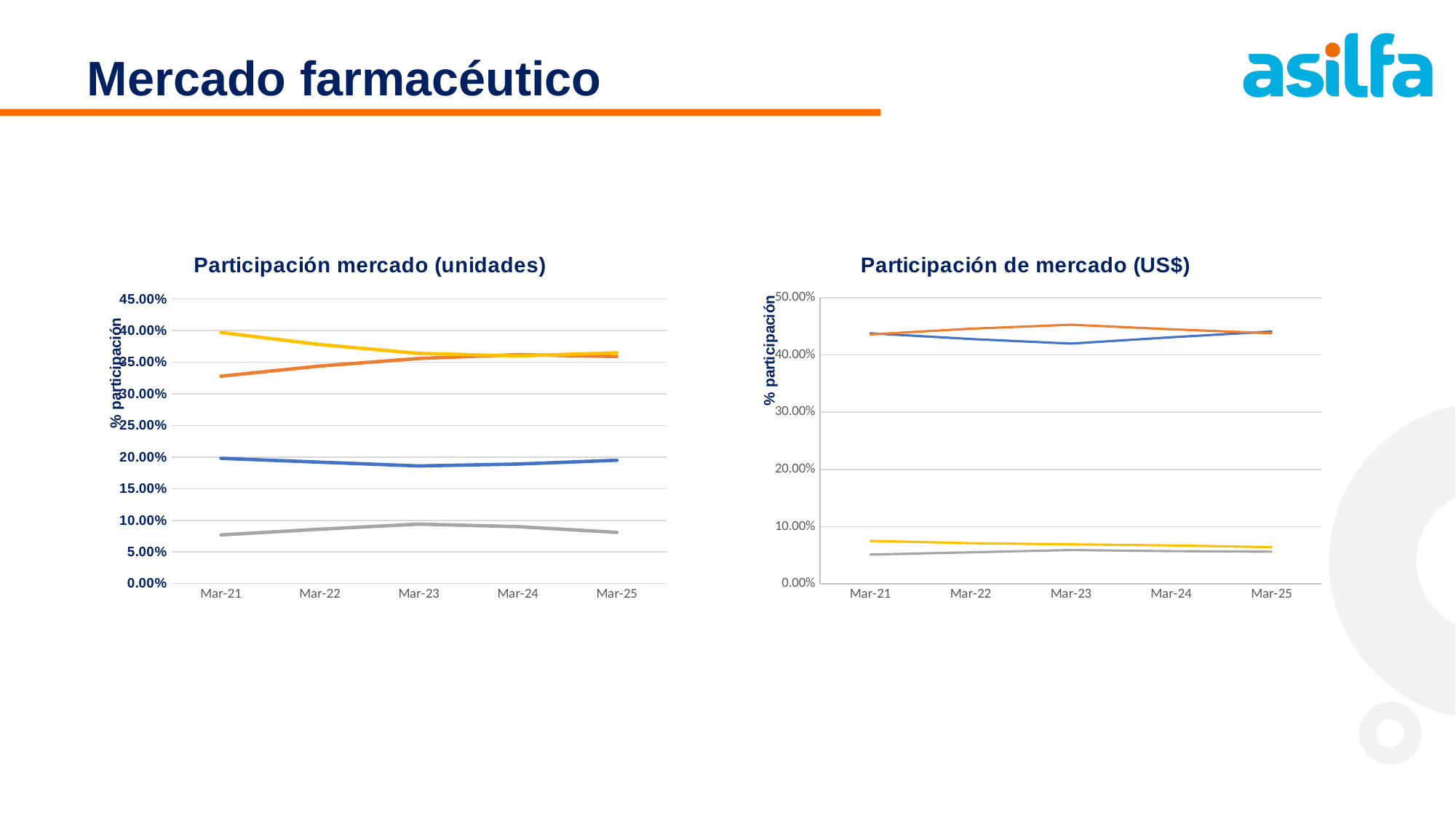
In the 'Participación mercado (unidades)' chart, is the value of the blue line at Mar-21 greater or less than 15.00%? greater In the 'Participación mercado (unidades)' chart, which line has the highest value at Mar-21? yellow line What kind of chart is 'Participación mercado (unidades)'? line chart In the 'Participación de mercado (US$)' chart, is the value of the yellow line at Mar-21 greater or less than 10.00%? less In the 'Participación de mercado (US$)' chart, which line is higher at Mar-23, the orange line or the blue line? orange line In the 'Participación mercado (unidades)' chart, how many points are shown along the x axis? 5 In the 'Participación de mercado (US$)' chart, is the value of the orange line at Mar-23 greater or less than 40.00%? greater In the 'Participación mercado (unidades)' chart, does the yellow line rise or fall from Mar-21 to Mar-25? falls In the 'Participación mercado (unidades)' chart, does the orange line rise or fall from Mar-21 to Mar-25? rises In the 'Participación de mercado (US$)' chart, how many lines are plotted? 4